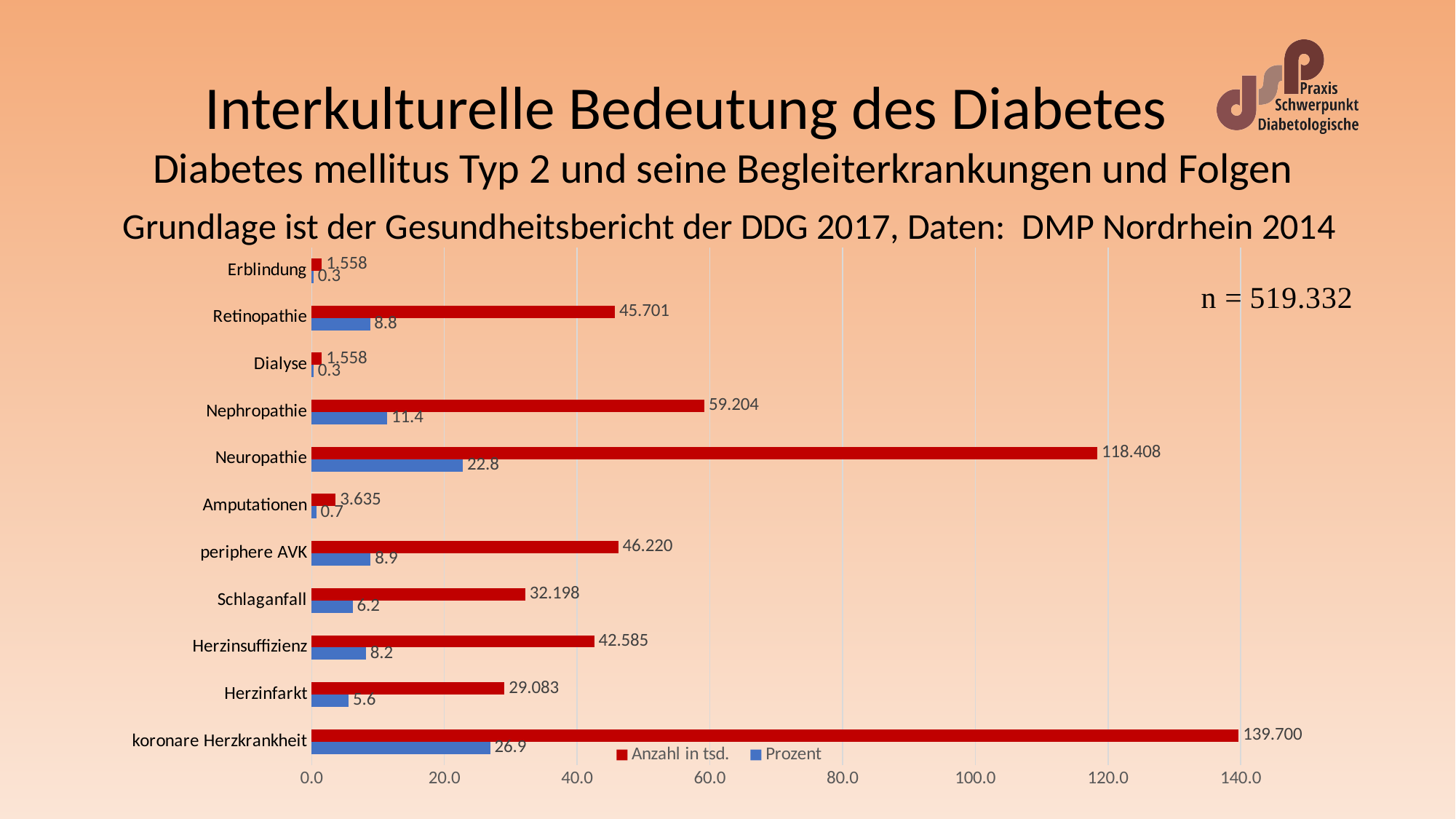
Which has a larger "Prozent" value, Herzinsuffizienz or Schlaganfall? Herzinsuffizienz Which has a larger "Anzahl in tsd." value, Retinopathie or periphere AVK? periphere AVK What is the "Anzahl in tsd." value for Herzinfarkt? 29.083 What kind of chart is shown on the slide? bar chart Which category has the highest "Prozent" value? koronare Herzkrankheit What is the difference between the "Prozent" values for Neuropathie and Nephropathie? 11.4 Is the "Anzahl in tsd." value for Nephropathie greater or less than 40.0? greater Which category has the highest "Anzahl in tsd." value? koronare Herzkrankheit How many categories are shown on the chart? 11 What is the value of "Anzahl in tsd." for Neuropathie? 118.408 What is the "Prozent" value for Schlaganfall? 6.2 How many series does the legend list? 2